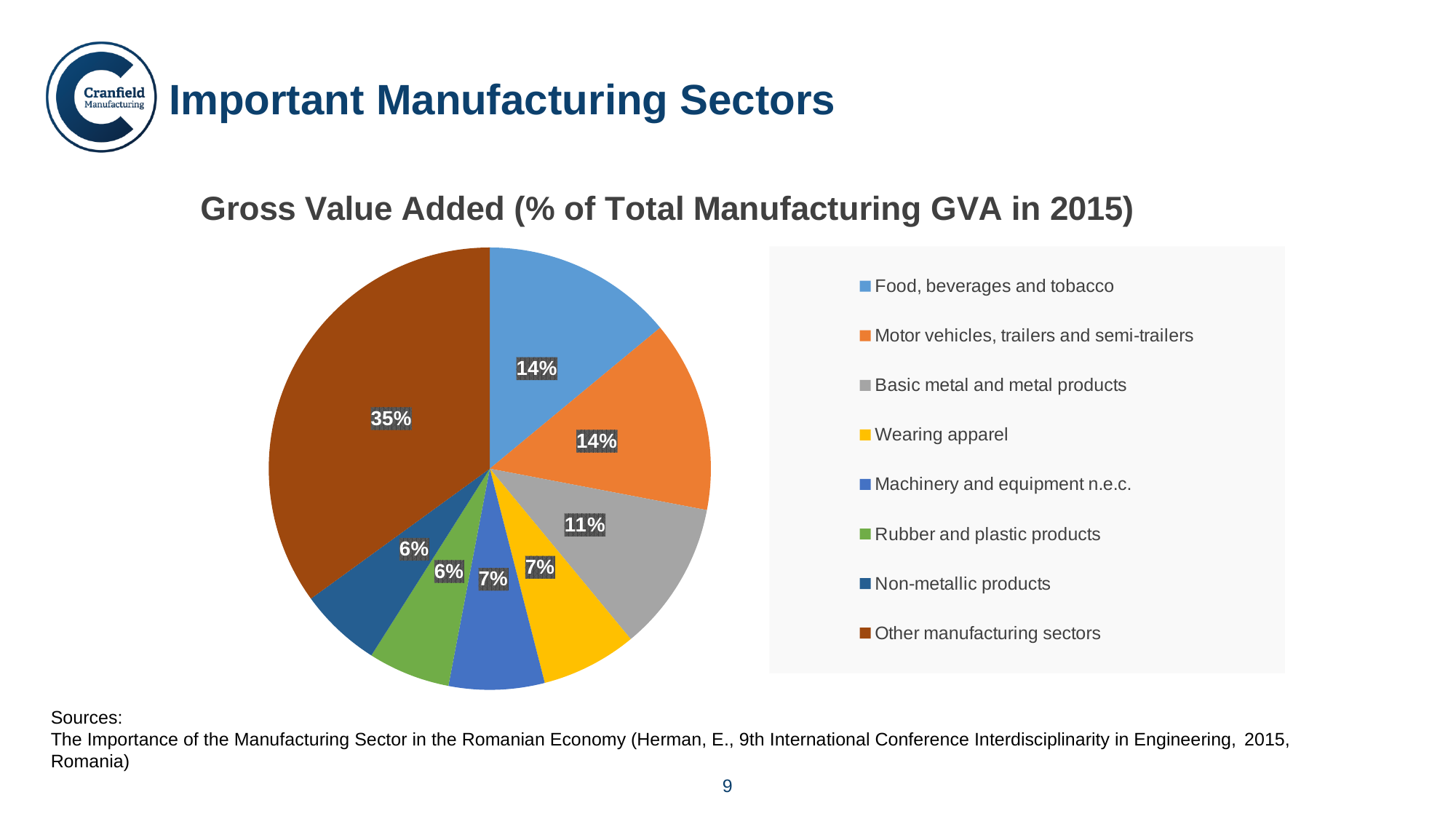
What share of total manufacturing GVA does Food, beverages and tobacco account for? 14% What is the combined share of Food, beverages and tobacco and Motor vehicles, trailers and semi-trailers? 28% What is the title of the chart? Gross Value Added (% of Total Manufacturing GVA in 2015) What is the difference in percentage points between Other manufacturing sectors and Motor vehicles, trailers and semi-trailers? 21 percentage points What is the value for Wearing apparel? 7% What type of chart is shown on the slide? Pie chart Which is larger, the share for Basic metal and metal products or the share for Machinery and equipment n.e.c.? Basic metal and metal products What share is shown for Non-metallic products? 6% How many sectors are shown in the pie chart? 8 Which sector has the largest slice of the pie? Other manufacturing sectors What percentage is shown for Basic metal and metal products? 11% Which sector is represented by the yellow slice? Wearing apparel